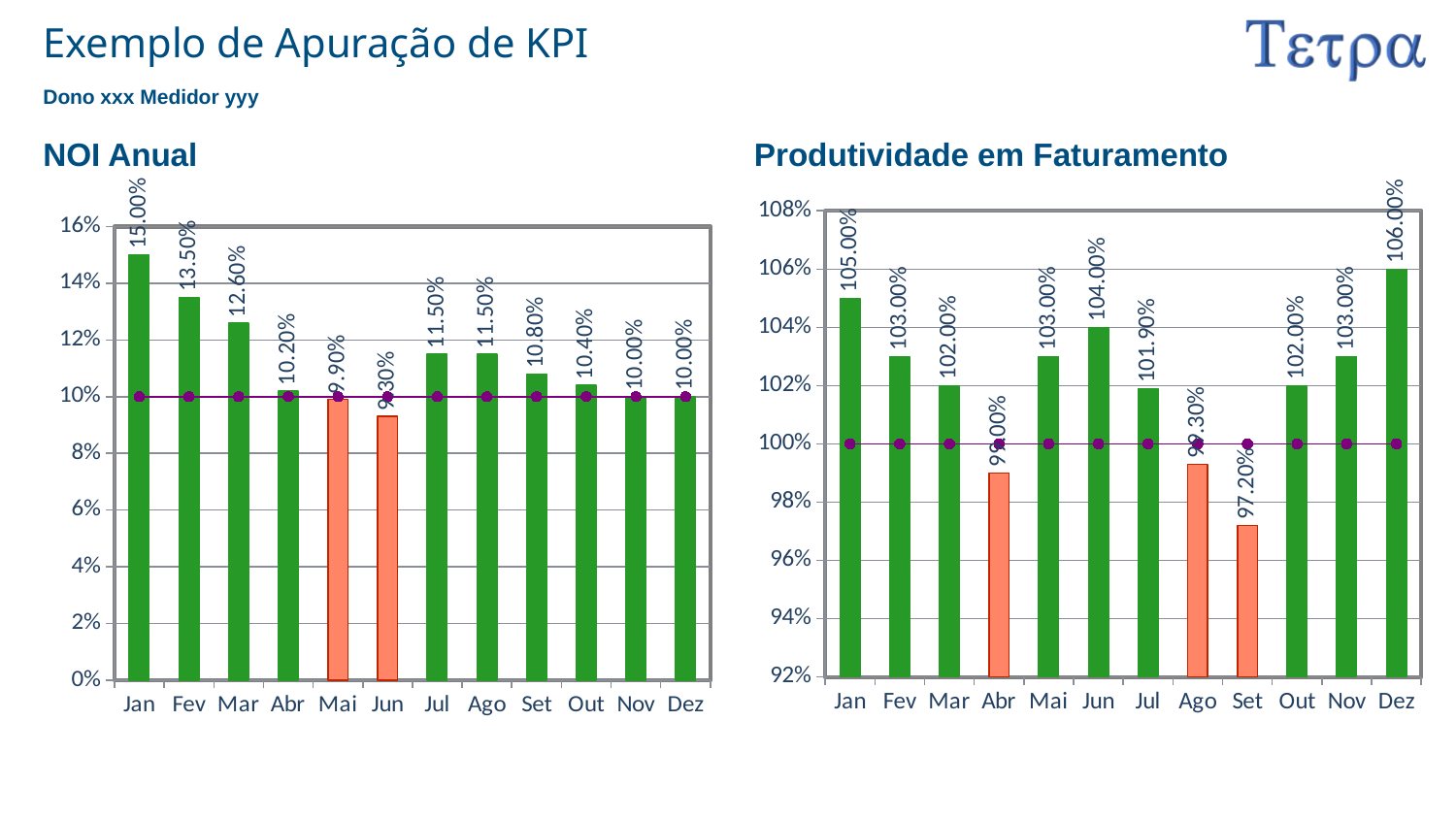
In the NOI Anual chart, which month has the lowest bar? Jun In the NOI Anual chart, what is the value for Mai? 9.90% In the NOI Anual chart, how many months are shown on the x axis? 12 In the NOI Anual chart, what is the value for Jan? 15.00% In the Produtividade em Faturamento chart, which month has the highest bar? Dez In the Produtividade em Faturamento chart, what is the value for Dez? 106.00% What kind of chart is the Produtividade em Faturamento chart? Combination bar and line chart In the NOI Anual chart, which is larger, the value for Mar or the value for Set? Mar In the Produtividade em Faturamento chart, what is the difference between the values for Jun and Jul? 2.10% In the NOI Anual chart, what is the difference between the values for Jan and Fev? 1.50% In the Produtividade em Faturamento chart, which month has the lowest bar? Set In the Produtividade em Faturamento chart, how many bars are coloured orange instead of green? 3